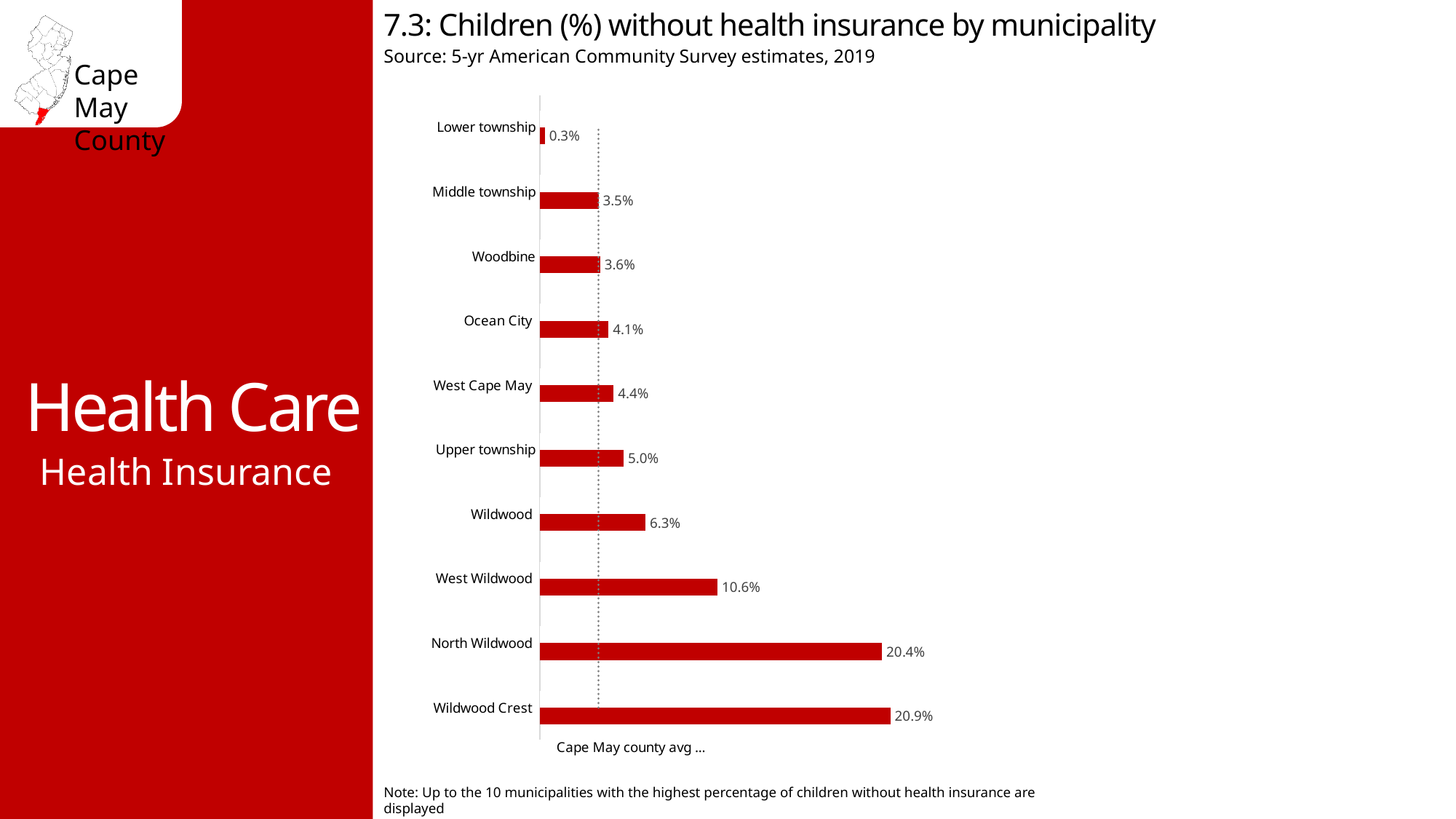
Which municipality has the lowest percentage of children without health insurance? Lower township What is the difference between the values for North Wildwood and Wildwood? 14.1% How many municipalities are shown in the chart? 10 What is the difference between the values for Upper township and Middle township? 1.5% What is the value shown for West Wildwood? 10.6% Which municipality has the highest percentage of children without health insurance? Wildwood Crest What is the value shown for Ocean City? 4.1% Which has a higher value, West Cape May or Woodbine? West Cape May What does the dotted vertical line in the chart represent? Cape May county avg What type of chart is shown on the slide? Bar chart Which has a higher value, Wildwood or West Wildwood? West Wildwood What percentage of children are without health insurance in Wildwood Crest? 20.9%